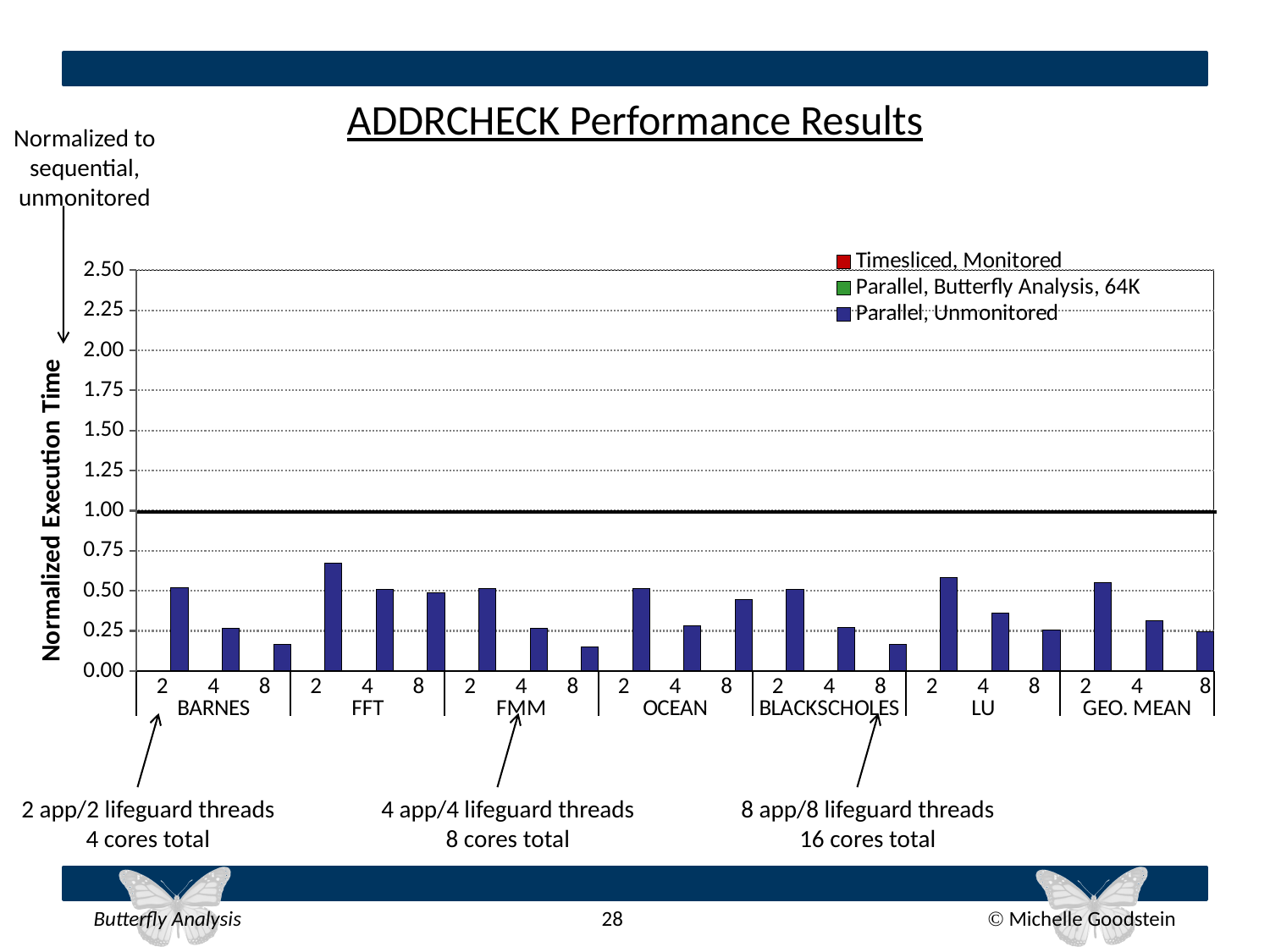
Is the value for OCEAN with 4 threads greater or less than 0.50? less Do the values for BARNES rise or fall as the thread count goes from 2 to 8? fall How many bars are plotted in the chart in total? 21 How many benchmark groups are shown along the x axis of the chart? 7 Is the value for FFT with 2 threads greater or less than 0.50? greater What is the title of the chart's y axis? Normalized Execution Time What is the title of the chart? ADDRCHECK Performance Results Which benchmark group contains the tallest bar in the chart? FFT How many series does the chart legend list? 3 What kind of chart is shown on the slide? bar chart Is the value for BARNES with 8 threads greater or less than 0.25? less Which is larger, the value for FFT with 2 threads or the value for LU with 2 threads? FFT with 2 threads